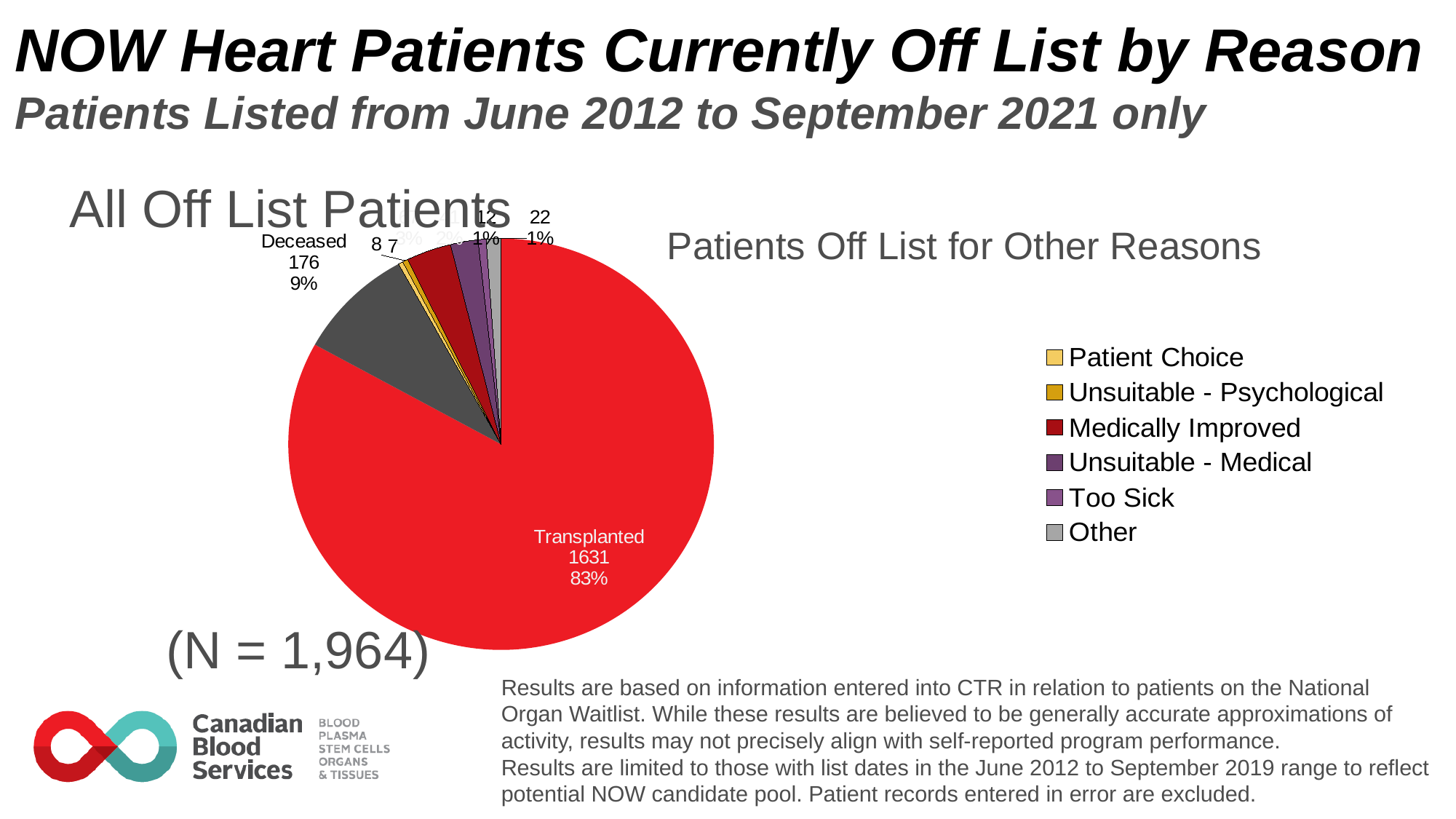
What share of the pie does the Transplanted slice represent? 83% How many patients are in the Transplanted slice of the pie chart? 1631 What share of the pie does the Deceased slice represent? 9% What is the title of the pie chart? All Off List Patients What is the difference between the number of Transplanted patients and the number of Deceased patients? 1455 How many patients are in the Deceased slice of the pie chart? 176 How many entries does the legend for 'Patients Off List for Other Reasons' list? 6 What is the total number of patients (N) shown for the pie chart? 1,964 Which slice of the pie chart is the largest? Transplanted What kind of chart is shown on the slide? pie chart Which is larger, the Transplanted slice or the Deceased slice? Transplanted Which legend entry is shown in grey? Other